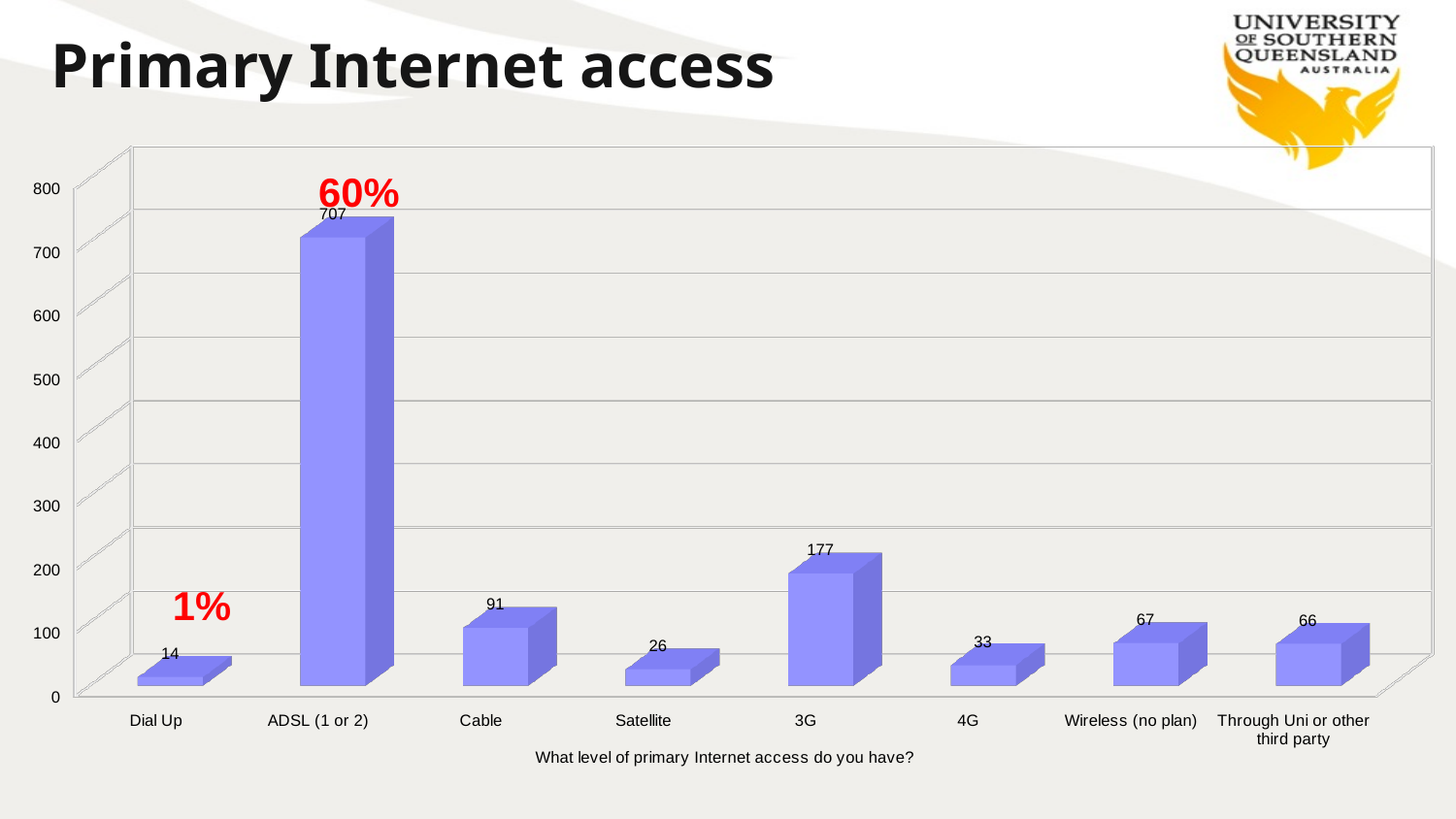
What is the difference between the values for 3G and Cable? 86 What is the value for 3G? 177 What kind of chart is shown on the slide? bar chart Which is larger, the value for Cable or the value for 4G? Cable Which category has the highest value? ADSL (1 or 2) Which category has the lowest value? Dial Up What is the value for Satellite? 26 Is the value for 3G greater or less than 100? greater What percentage annotation is shown above the ADSL (1 or 2) bar? 60% What is the value for ADSL (1 or 2)? 707 How many categories are shown on the x axis? 8 What is the x-axis title of the chart? What level of primary Internet access do you have?